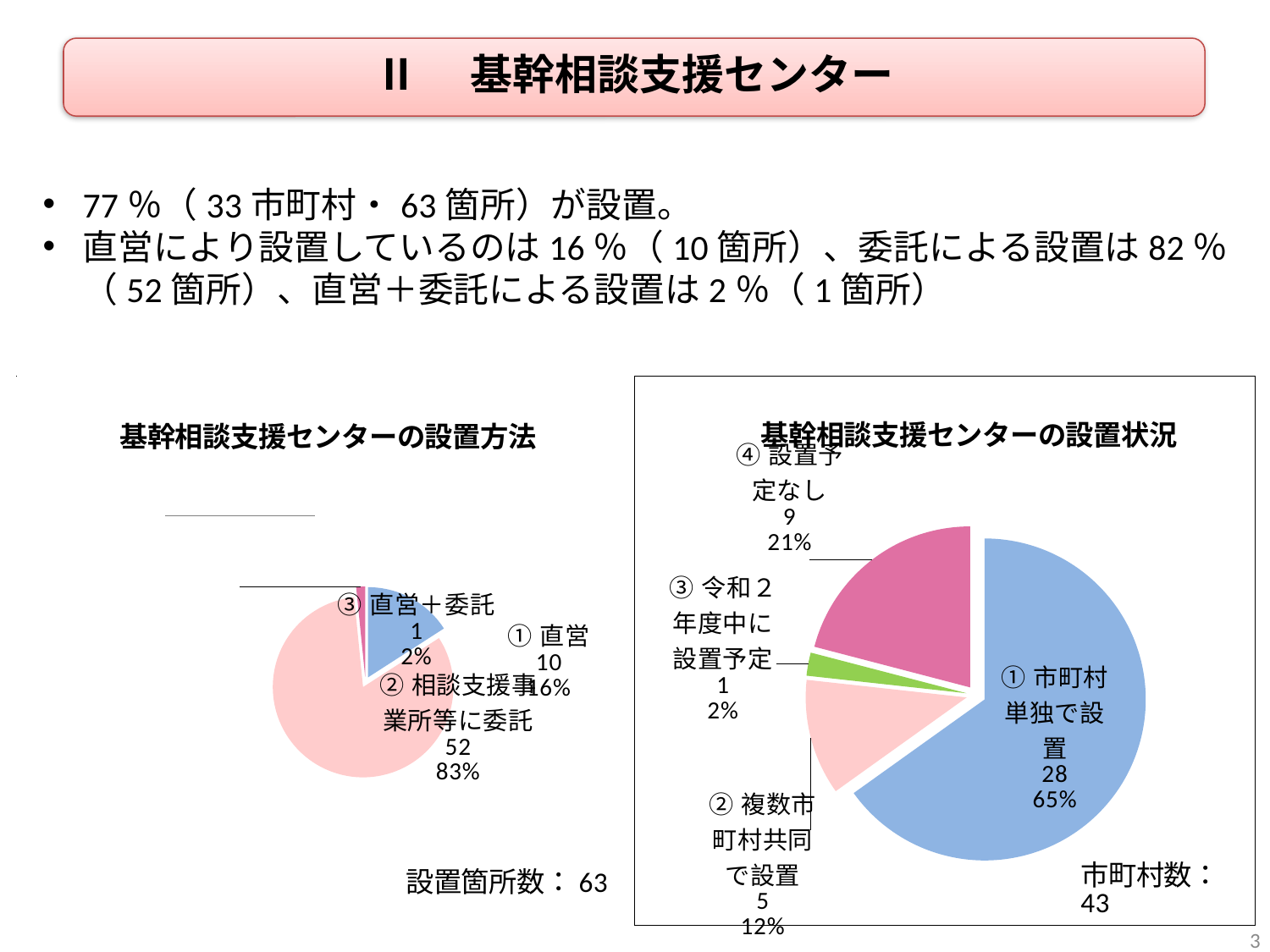
In the 「基幹相談支援センターの設置状況」 chart, what is the value for 「① 市町村単独で設置」? 28 In the 「基幹相談支援センターの設置方法」 chart, what is the difference between 「② 相談支援事業所等に委託」 and 「① 直営」? 42 In the 「基幹相談支援センターの設置状況」 chart, which category is the largest? ① 市町村単独で設置 In the 「基幹相談支援センターの設置方法」 chart, how many categories are there? 3 In the 「基幹相談支援センターの設置方法」 chart, which category is the smallest? ③ 直営＋委託 In the 「基幹相談支援センターの設置状況」 chart, what is the difference between 「④ 設置予定なし」 and 「② 複数市町村共同で設置」? 4 In the 「基幹相談支援センターの設置方法」 chart, what is the value for 「② 相談支援事業所等に委託」? 52 In the 「基幹相談支援センターの設置状況」 chart, which is larger, 「② 複数市町村共同で設置」 or 「④ 設置予定なし」? ④ 設置予定なし What kind of chart is 「基幹相談支援センターの設置方法」? pie chart In the 「基幹相談支援センターの設置状況」 chart, how many categories are there? 4 In the 「基幹相談支援センターの設置方法」 chart, what share of the pie is 「① 直営」? 16% In the 「基幹相談支援センターの設置状況」 chart, what share of the pie is 「④ 設置予定なし」? 21%